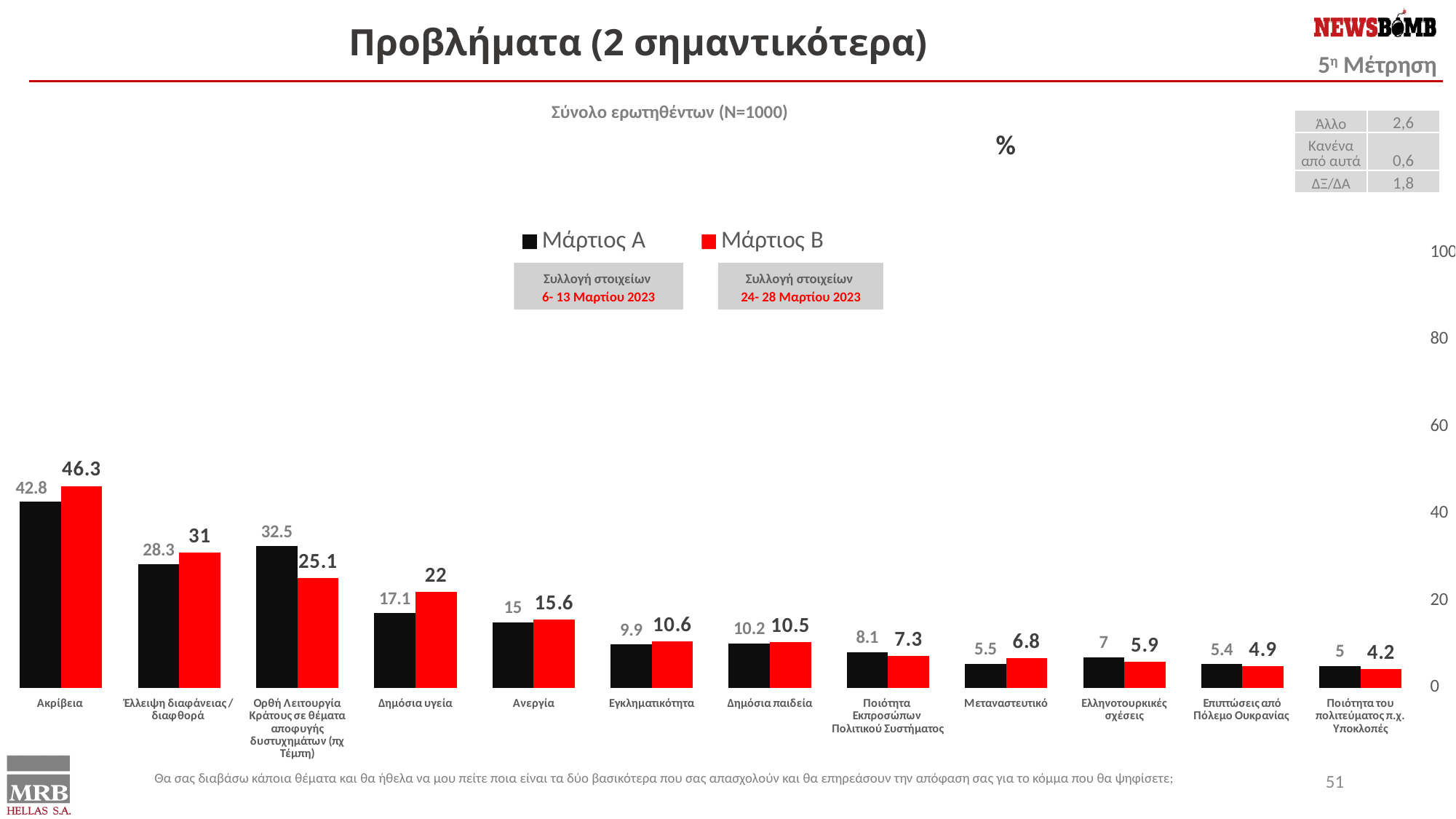
What is the difference between the Μάρτιος Α and Μάρτιος Β values for Ορθή Λειτουργία Κράτους σε θέματα αποφυγής δυστυχημάτων (πχ Τέμπη)? 7.4 How many series does the legend list? 2 Which category has the highest Μάρτιος Β value? Ακρίβεια Is the Μάρτιος Α value for Έλλειψη διαφάνειας / διαφθορά greater or less than 20? greater For Ελληνοτουρκικές σχέσεις, which is larger: the Μάρτιος Α value or the Μάρτιος Β value? Μάρτιος Α What kind of chart is shown on the slide? Bar chart What is the difference between the Μάρτιος Β and Μάρτιος Α values for Ακρίβεια? 3.5 What is the Μάρτιος Β value for Ακρίβεια? 46.3 Which category has the lowest Μάρτιος Β value? Ποιότητα του πολιτεύματος π.χ. Υποκλοπές How many categories are shown on the x axis of the chart? 12 What is the Μάρτιος Β value for Δημόσια υγεία? 22 What is the Μάρτιος Α value for Ορθή Λειτουργία Κράτους σε θέματα αποφυγής δυστυχημάτων (πχ Τέμπη)? 32.5